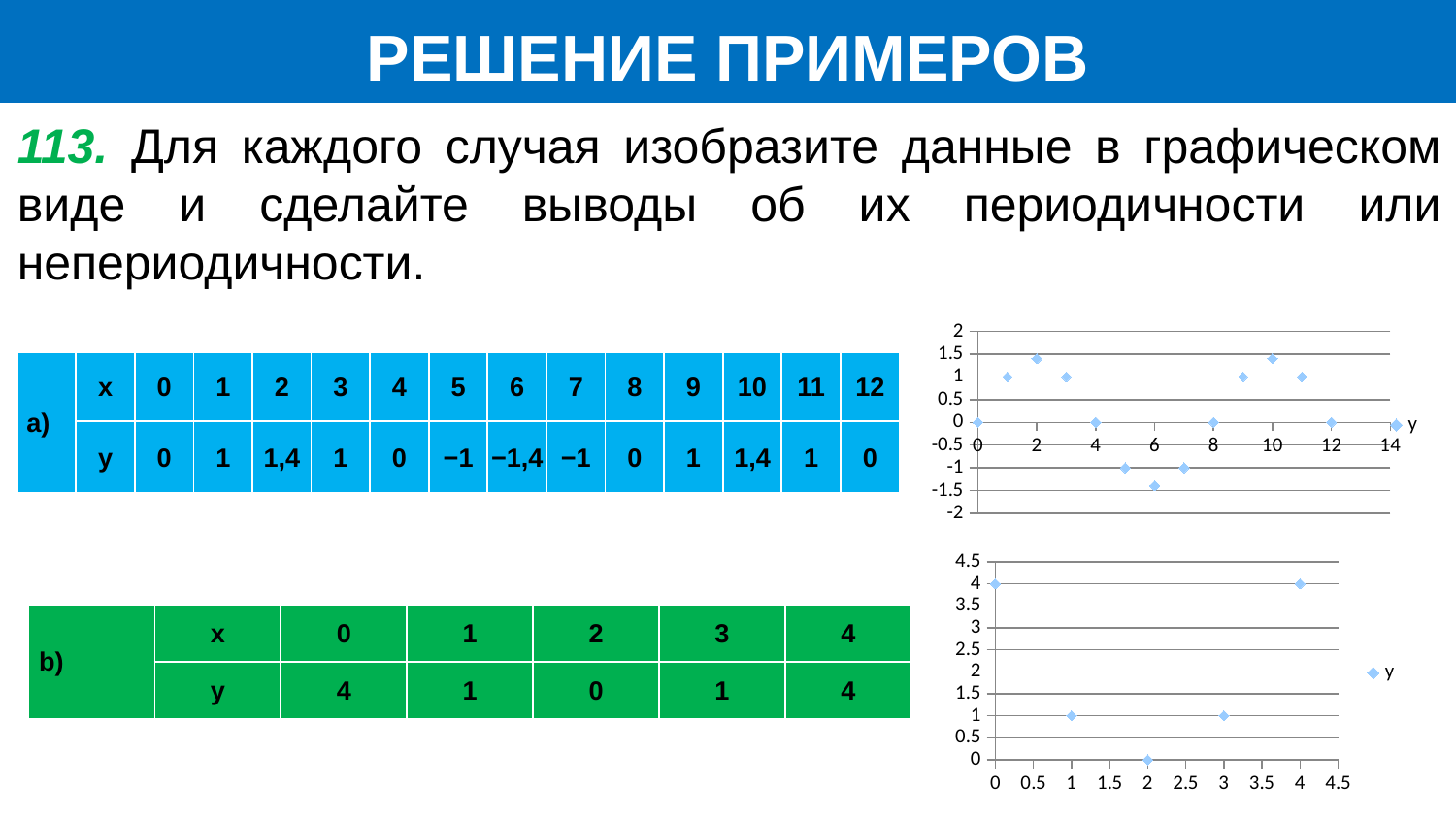
How many series does the legend of the top chart list? 1 In the bottom chart, do the y values rise or fall as x goes from 0 to 2? fall What kind of chart is the top chart on the right of the slide? scatter chart In the top chart, at which x value is the lowest y value plotted? 6 In the top chart, is the y value at x = 2 greater or less than 1? greater In the bottom chart, what is the difference between the y value at x = 0 and the y value at x = 1? 3 In the bottom chart, what is the y value at x = 4? 4 How many data points are plotted in the top chart on the right of the slide? 13 How many data points are plotted in the bottom chart on the right of the slide? 5 In the bottom chart, what is the y value at x = 2? 0 In the bottom chart, what is the highest y value plotted? 4 In the bottom chart, which has the larger y value: x = 0 or x = 1? x = 0